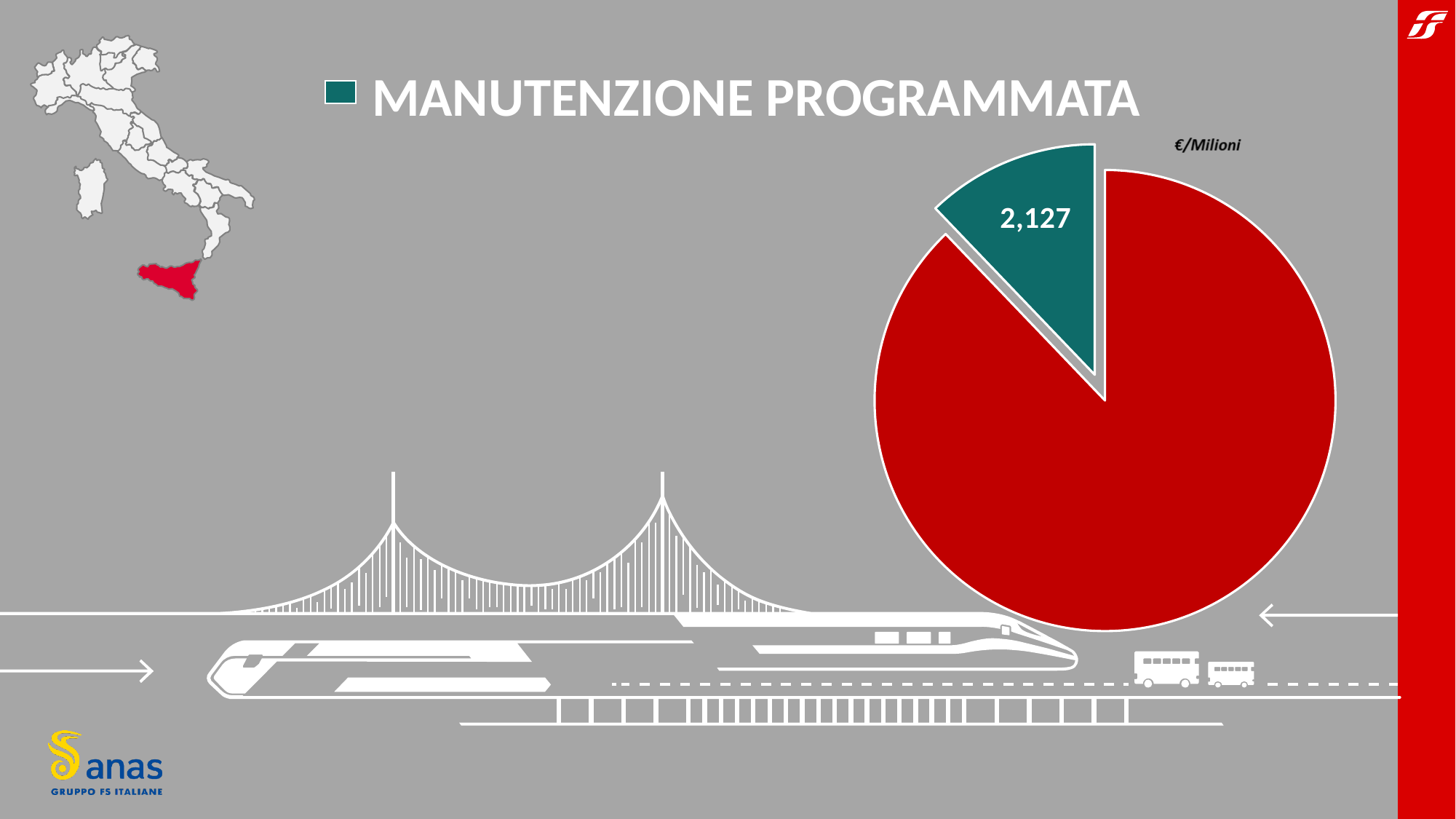
What unit is indicated next to the pie chart? €/Milioni Which slice of the pie chart is larger, the red one or the teal one? red What colour is the slice labelled Manutenzione Programmata in the legend? teal What value is printed on the teal slice of the pie chart? 2,127 How many slices does the pie chart have? 2 How many entries does the legend of the pie chart list? 1 Is the Manutenzione Programmata slice the larger or the smaller slice of the pie chart? smaller What is the value for Manutenzione Programmata in the pie chart? 2,127 What kind of chart is shown on the slide? pie chart